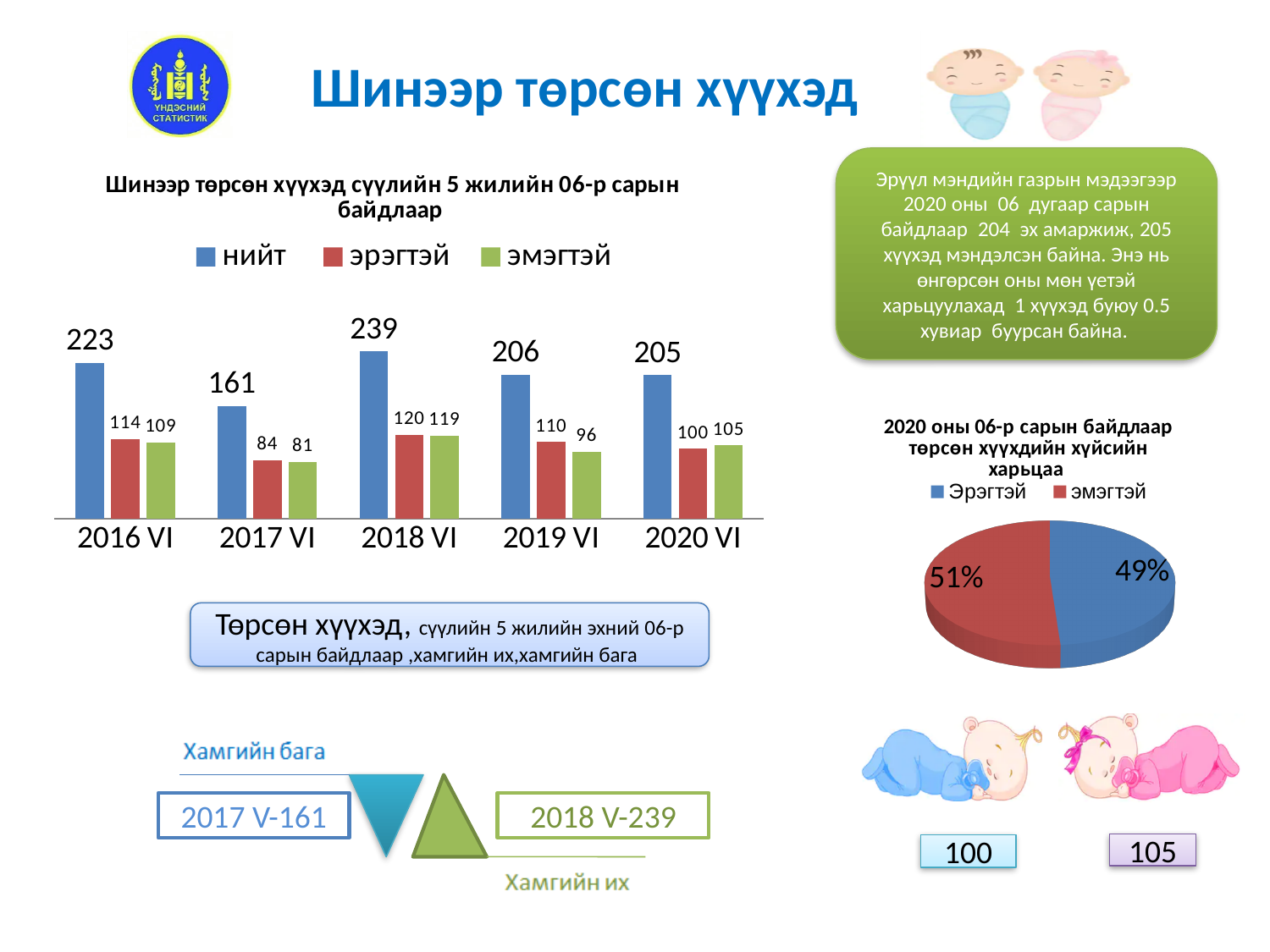
In the pie chart, which slice is larger: Эрэгтэй or эмэгтэй? эмэгтэй In the bar chart, which year has the highest нийт value? 2018 VI In the bar chart, what is the value of эрэгтэй for 2017 VI? 84 In the bar chart, for 2020 VI, which is larger: эрэгтэй or эмэгтэй? эмэгтэй In the bar chart, which year has the lowest нийт value? 2017 VI What kind of chart is the chart titled 'Шинээр төрсөн хүүхэд сүүлийн 5 жилийн 06-р сарын байдлаар'? bar chart How many series does the legend of the bar chart list? 3 In the bar chart, what is the value of эмэгтэй for 2019 VI? 96 In the pie chart, what share is labelled for Эрэгтэй? 49% How many categories are shown on the x axis of the bar chart? 5 In the bar chart, what is the value of нийт for 2018 VI? 239 In the bar chart, what is the difference between the нийт values for 2018 VI and 2017 VI? 78